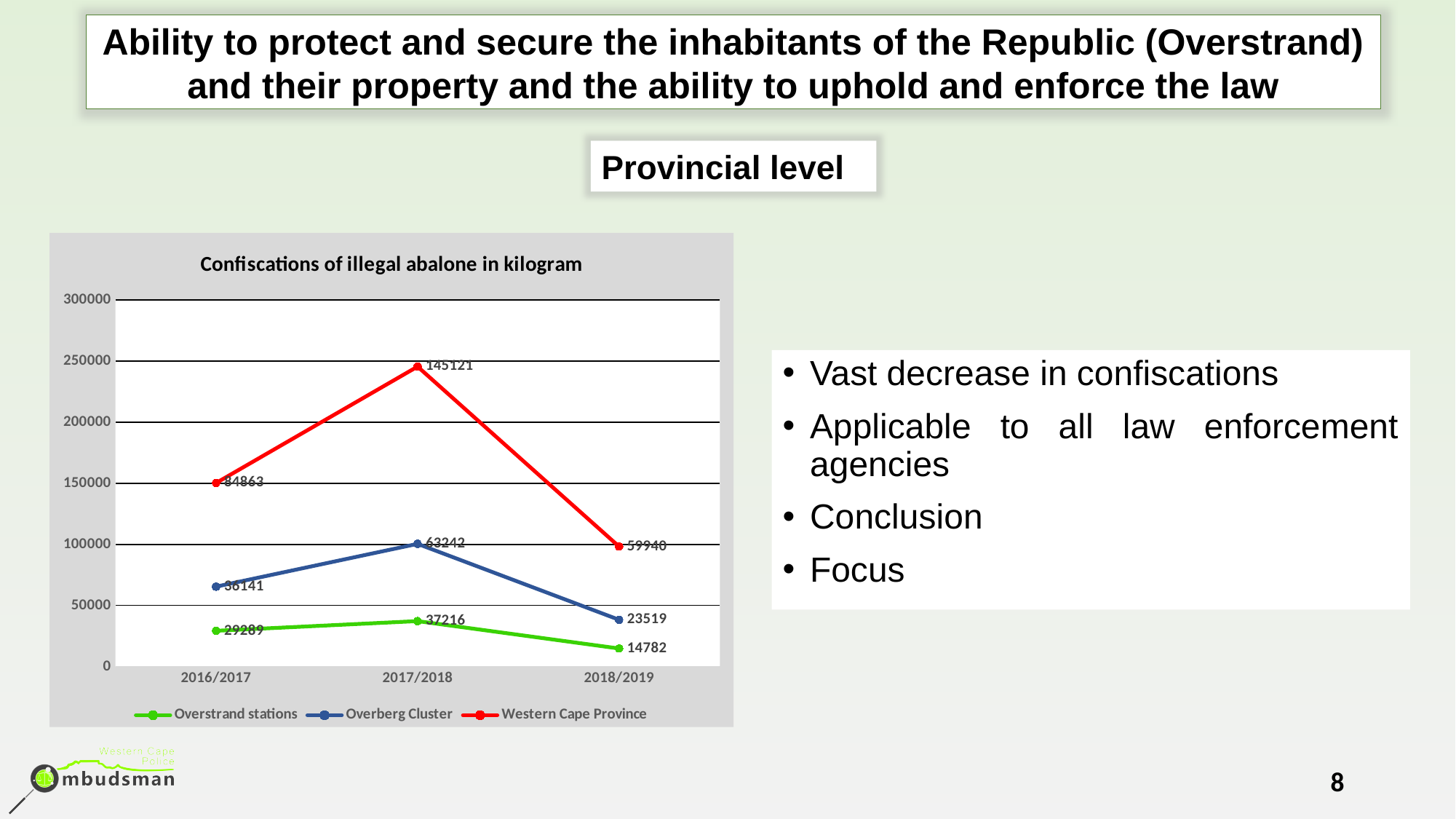
Which series is drawn in red on the chart? Western Cape Province What is the value for Overberg Cluster in 2017/2018? 63242 What is the value for Overstrand stations in 2018/2019? 14782 In which period is the Overstrand stations value lowest? 2018/2019 In which period is the Western Cape Province value highest? 2017/2018 What kind of chart is shown on the slide? line chart What is the value for Western Cape Province in 2017/2018? 145121 What is the value for Western Cape Province in 2018/2019? 59940 What is the title of the chart? Confiscations of illegal abalone in kilogram What is the difference between the Overstrand stations values for 2017/2018 and 2018/2019? 22434 How many series does the chart legend list? 3 How many periods are shown on the x axis of the chart? 3